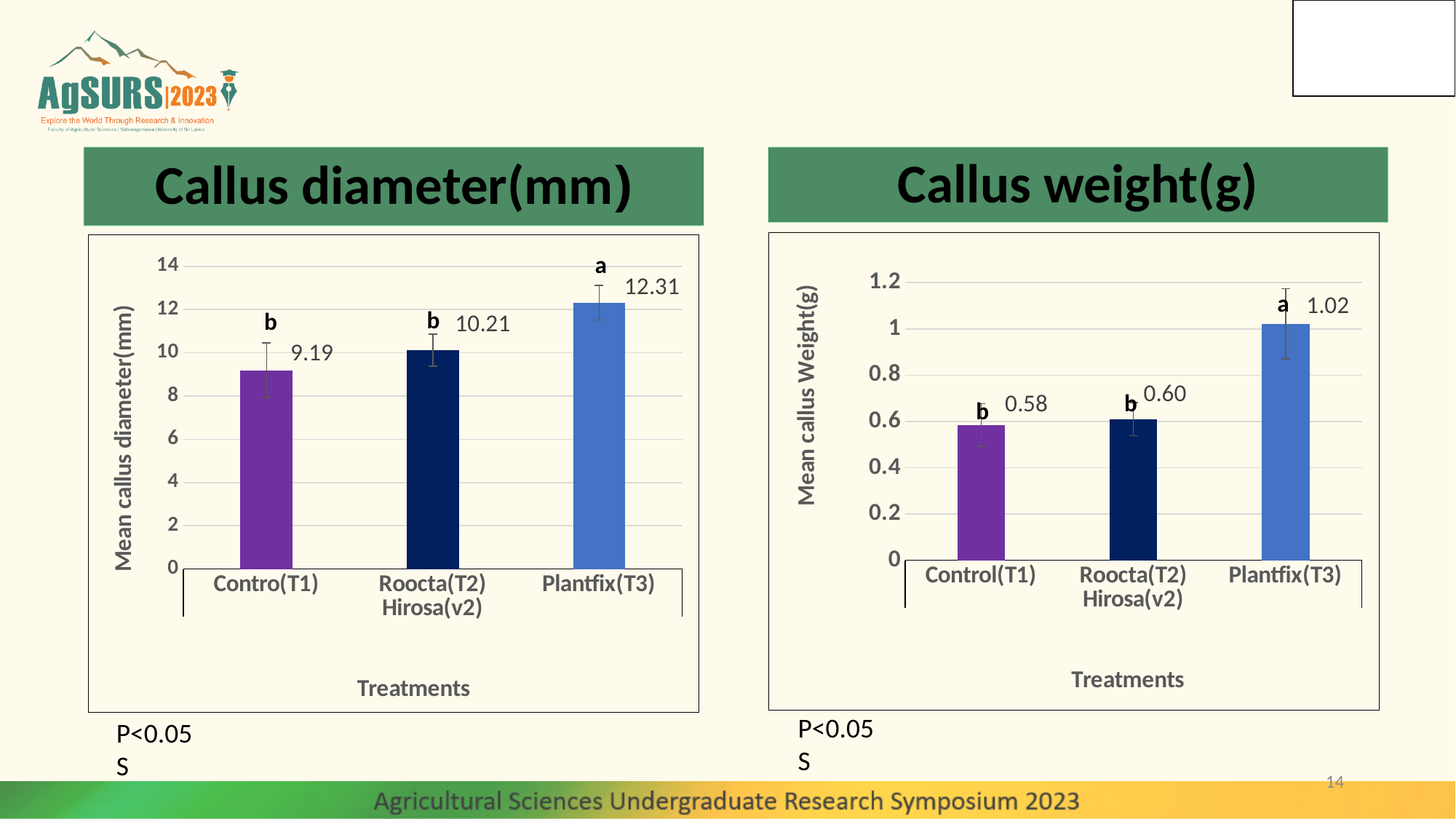
In the Callus diameter(mm) chart, which treatment has the highest mean callus diameter? Plantfix(T3) In the Callus weight(g) chart, which treatment has the lowest mean callus weight? Control(T1) In the Callus weight(g) chart, what is the mean callus weight for Roocta(T2) Hirosa(v2)? 0.60 In the Callus weight(g) chart, what is the mean callus weight for Plantfix(T3)? 1.02 In the Callus weight(g) chart, what is the difference between the values for Plantfix(T3) and Control(T1)? 0.44 In the Callus weight(g) chart, is the value for Plantfix(T3) greater or less than 0.8? greater In the Callus diameter(mm) chart, what is the mean callus diameter for Contro(T1)? 9.19 What type of chart is the Callus weight(g) chart? Bar chart In the Callus diameter(mm) chart, what is the mean callus diameter for Plantfix(T3)? 12.31 How many treatments are shown in the Callus diameter(mm) chart? 3 In the Callus diameter(mm) chart, what is the difference between the values for Plantfix(T3) and Roocta(T2) Hirosa(v2)? 2.10 In the Callus diameter(mm) chart, which treatment has the lowest mean callus diameter? Contro(T1)